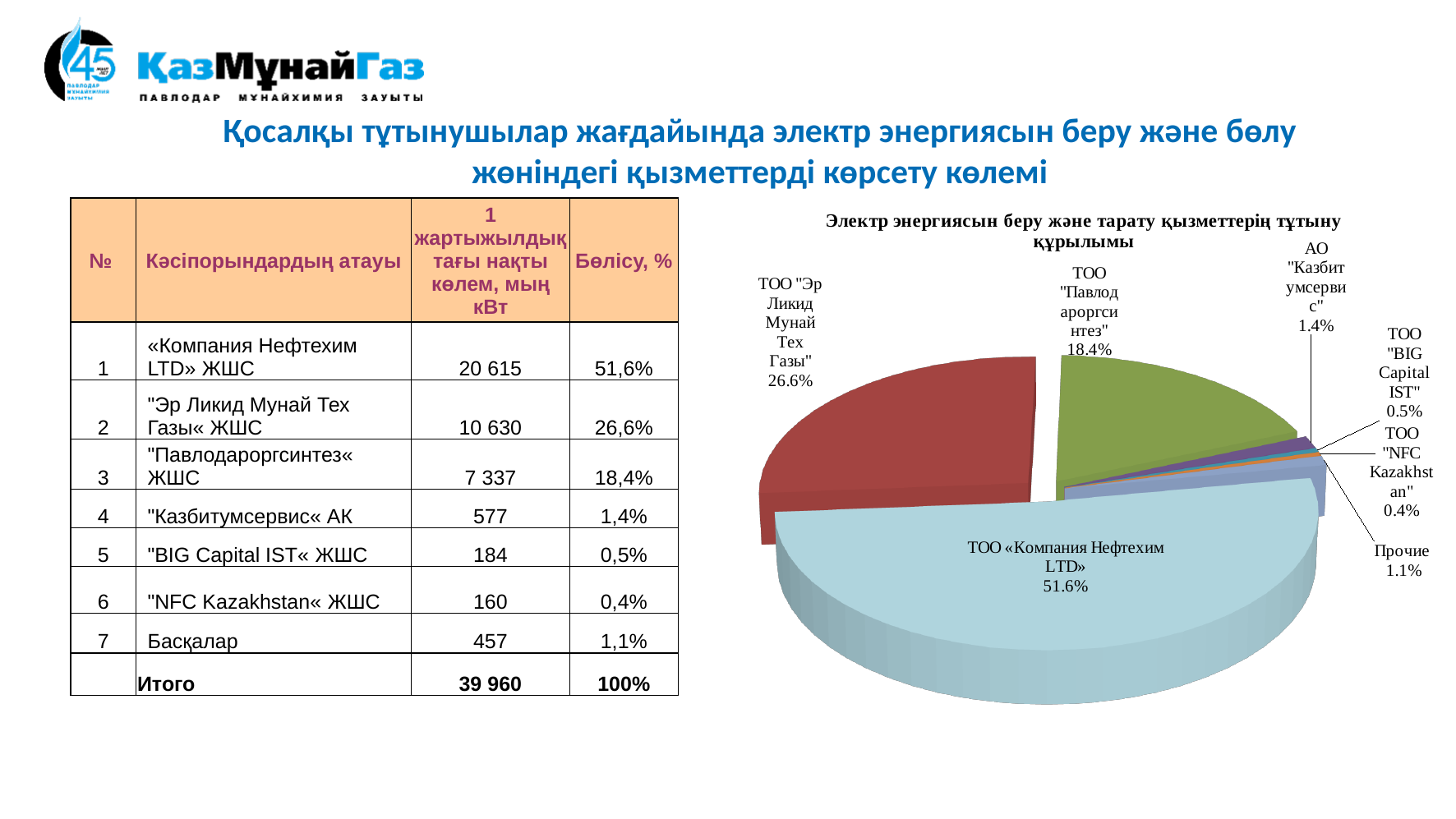
What percentage is shown for АО "Казбитумсервис" in the pie chart? 1.4% What type of chart is shown on the slide? pie chart What share of the pie chart does ТОО «Компания Нефтехим LTD» hold? 51.6% What percentage is shown for Прочие in the pie chart? 1.1% What is the difference in percentage points between ТОО "Эр Ликид Мунай Тех Газы" and ТОО "Павлодароргсинтез" in the pie chart? 8.2 Which slice of the pie chart is the smallest? ТОО "NFC Kazakhstan" How many slices does the pie chart have? 7 What percentage is shown for ТОО "Эр Ликид Мунай Тех Газы" in the pie chart? 26.6% What percentage is shown for ТОО "Павлодароргсинтез" in the pie chart? 18.4% Which has a larger share in the pie chart, ТОО "BIG Capital IST" or ТОО "NFC Kazakhstan"? ТОО "BIG Capital IST" Which slice of the pie chart is the largest? ТОО «Компания Нефтехим LTD» What is the title of the pie chart? Электр энергиясын беру және тарату қызметтерің тұтыну құрылымы